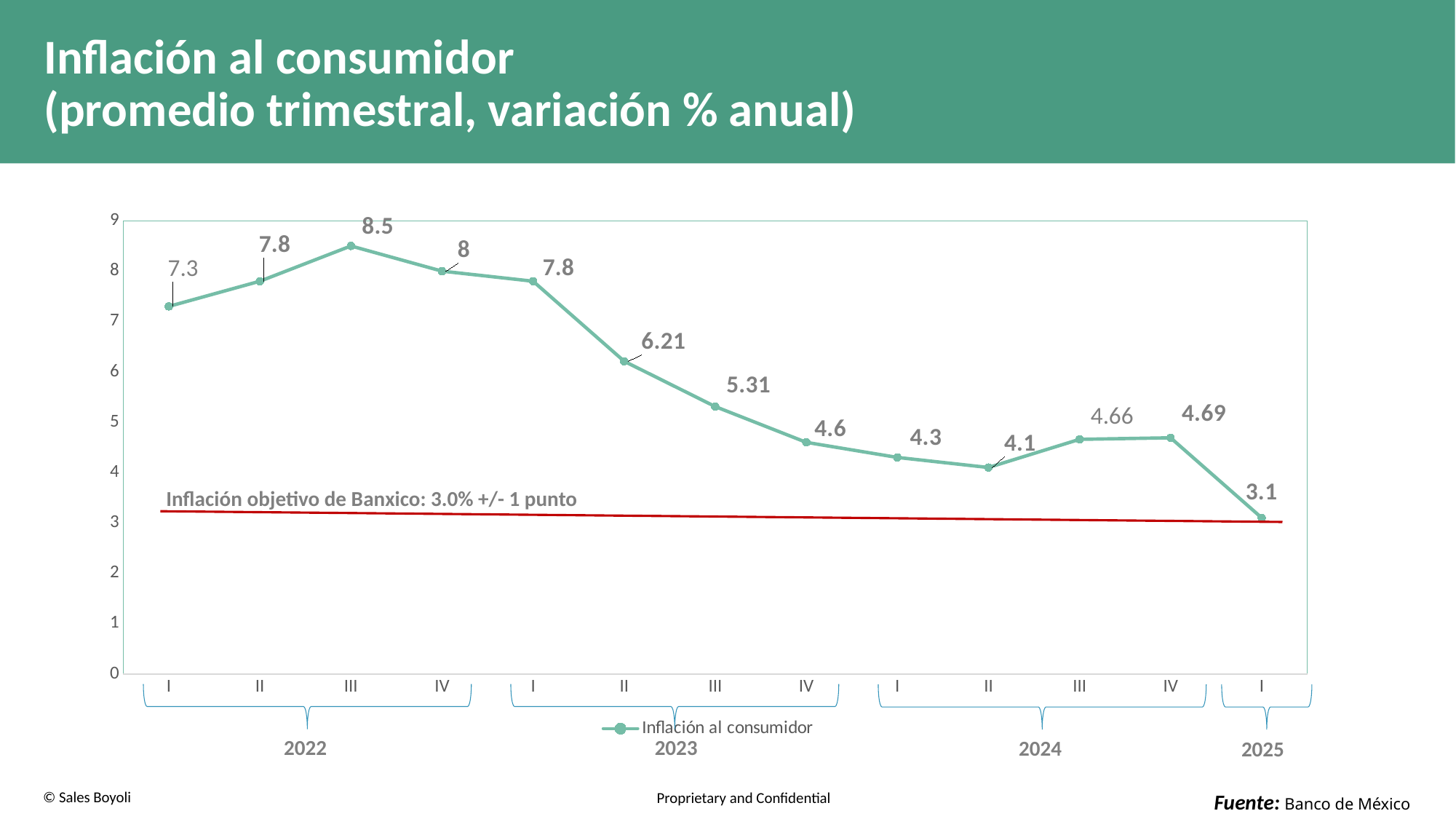
How many series does the legend list? 1 What is the value for quarter IV of 2024? 4.69 What is the value for quarter III of 2022? 8.5 What is the Banxico target inflation stated on the chart? 3.0% +/- 1 punto What is the difference between the value for quarter III of 2022 and quarter I of 2025? 5.4 Which quarter has the lowest value? I 2025 Which is larger, the value for quarter II of 2023 or quarter III of 2023? II 2023 What is the value for quarter II of 2023? 6.21 What type of chart is shown on the slide? line chart Which quarter has the highest value? III 2022 How many data points are plotted on the line? 13 What is the value for quarter I of 2025? 3.1